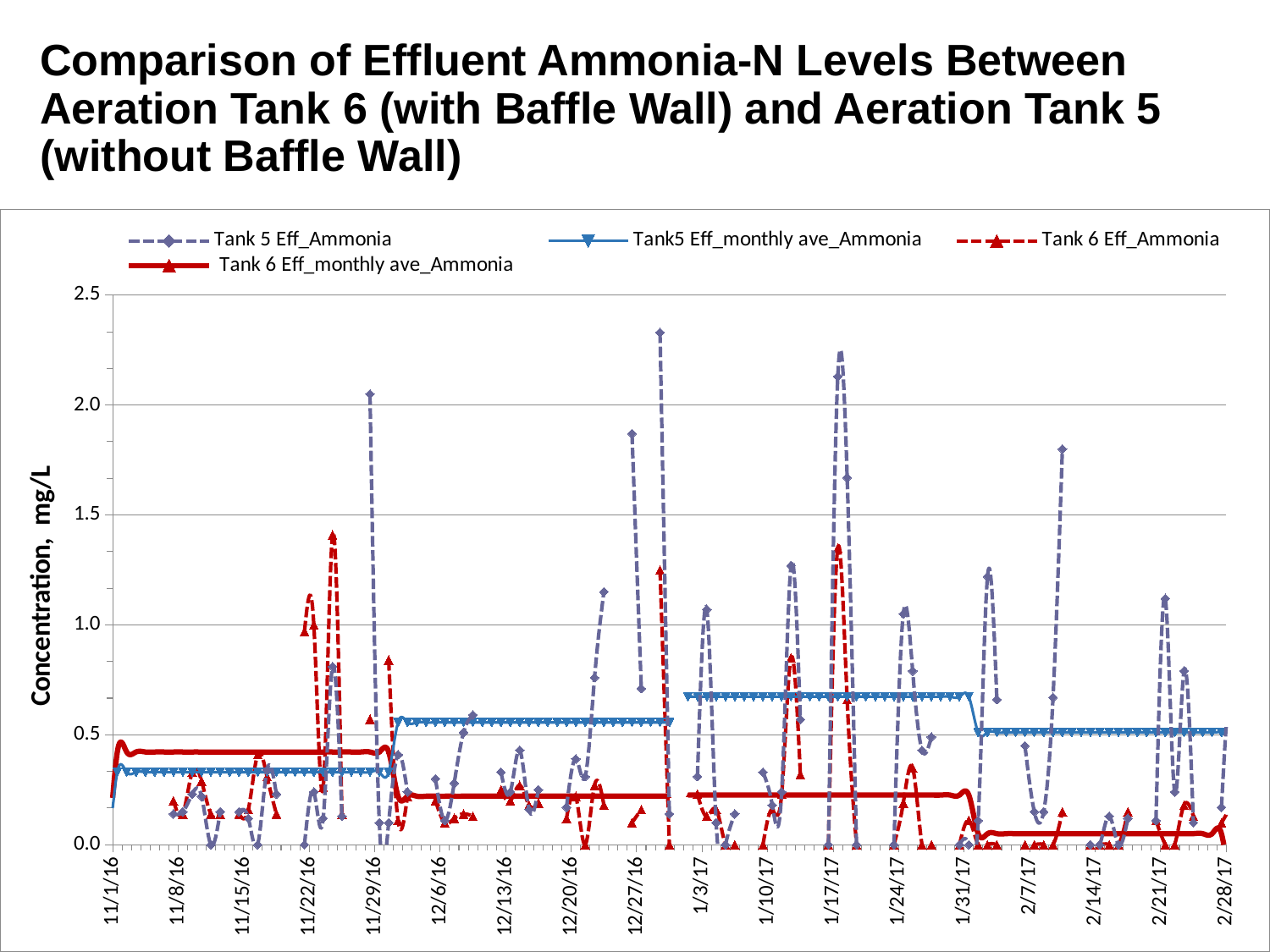
In November 2016, which monthly average is higher: Tank5 Eff_monthly ave_Ammonia or Tank 6 Eff_monthly ave_Ammonia? Tank 6 Eff_monthly ave_Ammonia Is the highest Tank 6 Eff_Ammonia value (near 11/24/16) greater or less than 1.0? greater How many series does the legend list? 4 Is the highest Tank 5 Eff_Ammonia value (near 12/29/16) greater or less than 2.0? greater Does the Tank 6 Eff_monthly ave_Ammonia line generally rise or fall from November 2016 to February 2017? fall What is the maximum value shown on the y axis? 2.5 Which series is drawn as a solid red line? Tank 6 Eff_monthly ave_Ammonia Is the Tank 6 Eff_monthly ave_Ammonia value in February 2017 greater or less than 0.5? less In December 2016, which monthly average is higher: Tank5 Eff_monthly ave_Ammonia or Tank 6 Eff_monthly ave_Ammonia? Tank5 Eff_monthly ave_Ammonia What is the label on the y axis? Concentration, mg/L What kind of chart is shown on the slide? line chart